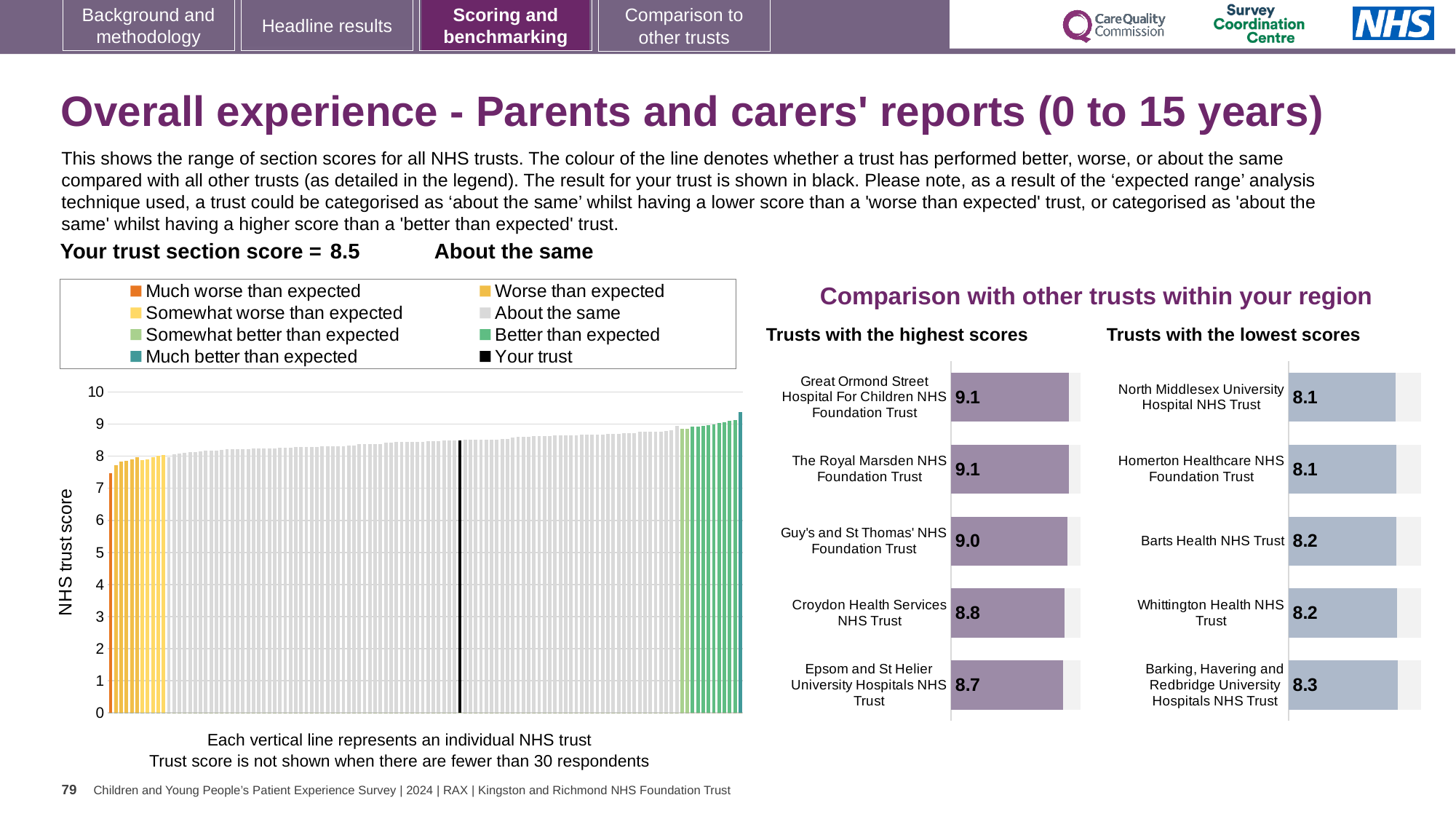
On the 'Trusts with the lowest scores' chart, what is the score for Barts Health NHS Trust? 8.2 How many trusts are shown on the 'Trusts with the lowest scores' chart? 5 On the main chart of all NHS trusts on the left, is the value of the lowest (orange) bar greater or less than 8? less On the 'Trusts with the highest scores' chart, which trust has the lowest score? Epsom and St Helier University Hospitals NHS Trust On the main chart of all NHS trusts on the left, what is the section score for your trust? 8.5 On the 'Trusts with the lowest scores' chart, what is the difference between the scores of Barking, Havering and Redbridge University Hospitals NHS Trust and North Middlesex University Hospital NHS Trust? 0.2 How many entries does the legend of the main chart on the left list? 8 On the 'Trusts with the highest scores' chart, what is the difference between the scores of Great Ormond Street Hospital For Children NHS Foundation Trust and Epsom and St Helier University Hospitals NHS Trust? 0.4 On the 'Trusts with the lowest scores' chart, which trust has the highest score? Barking, Havering and Redbridge University Hospitals NHS Trust On the 'Trusts with the highest scores' chart, which has the higher score: Guy's and St Thomas' NHS Foundation Trust or Croydon Health Services NHS Trust? Guy's and St Thomas' NHS Foundation Trust On the 'Trusts with the highest scores' chart, what is the score for Croydon Health Services NHS Trust? 8.8 On the 'Trusts with the highest scores' chart, what is the score for Great Ormond Street Hospital For Children NHS Foundation Trust? 9.1